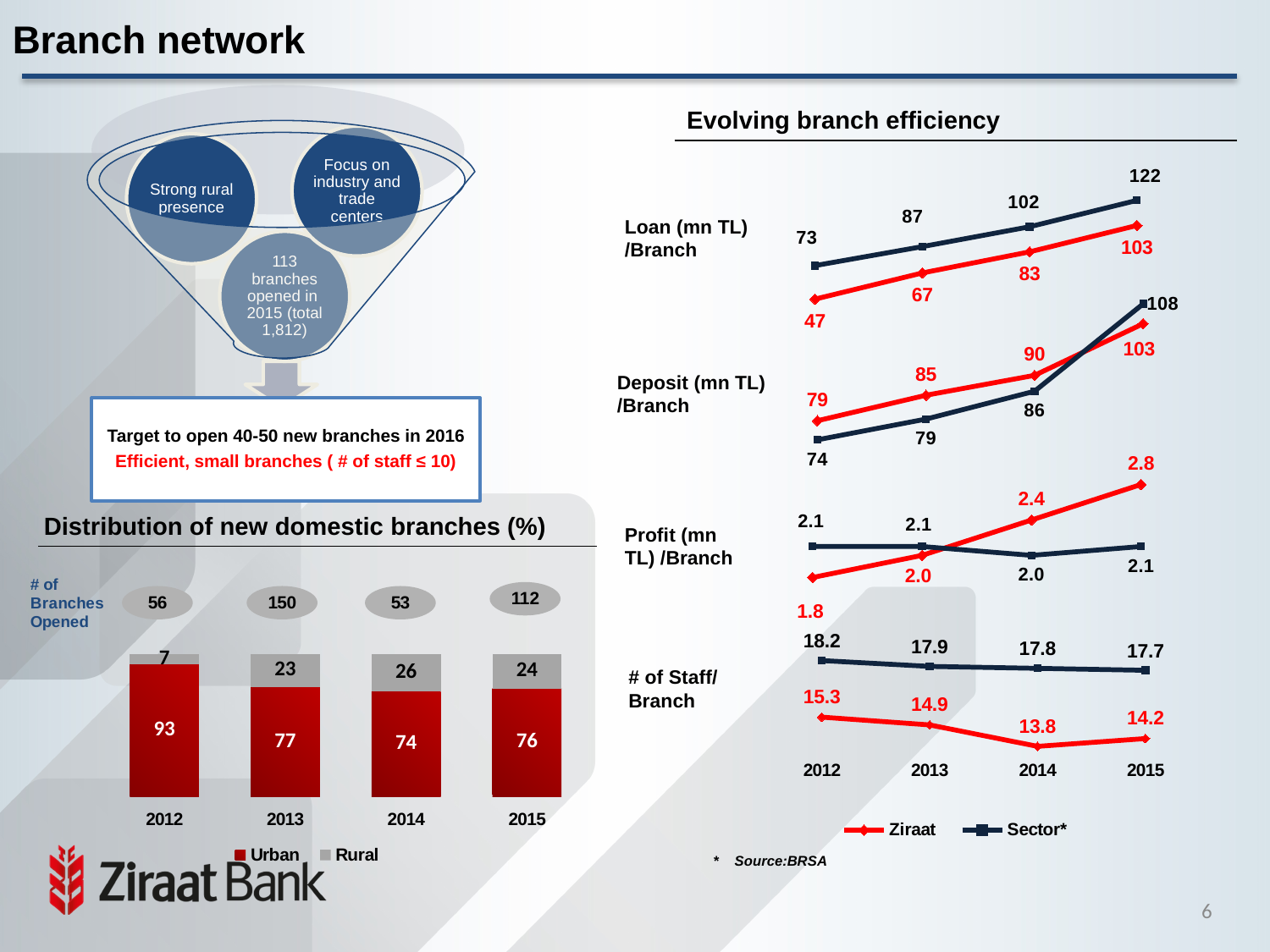
In the 'Evolving branch efficiency' Deposit (mn TL)/Branch chart, which is larger in 2015, Ziraat or Sector? Sector In the 'Evolving branch efficiency' # of Staff/Branch chart, what is the Ziraat value for 2014? 13.8 In the 'Distribution of new domestic branches (%)' chart, what is the Rural value for 2014? 26 In the 'Evolving branch efficiency' Loan (mn TL)/Branch chart, what is the Ziraat value for 2015? 103 In the 'Evolving branch efficiency' # of Staff/Branch chart, which year has the lowest Sector value? 2015 In the 'Distribution of new domestic branches (%)' chart, what is the difference between the Urban values for 2012 and 2013? 16 In the 'Distribution of new domestic branches (%)' chart, what kind of chart is shown? Stacked bar chart In the 'Distribution of new domestic branches (%)' chart, how many series does the legend list? 2 In the 'Evolving branch efficiency' Loan (mn TL)/Branch chart, what is the difference between the Sector and Ziraat values in 2012? 26 In the 'Distribution of new domestic branches (%)' chart, what is the Urban value for 2012? 93 In the 'Evolving branch efficiency' Profit (mn TL)/Branch chart, does the Ziraat line rise or fall from 2012 to 2015? Rise In the 'Distribution of new domestic branches (%)' chart, which year has the highest Rural share? 2014